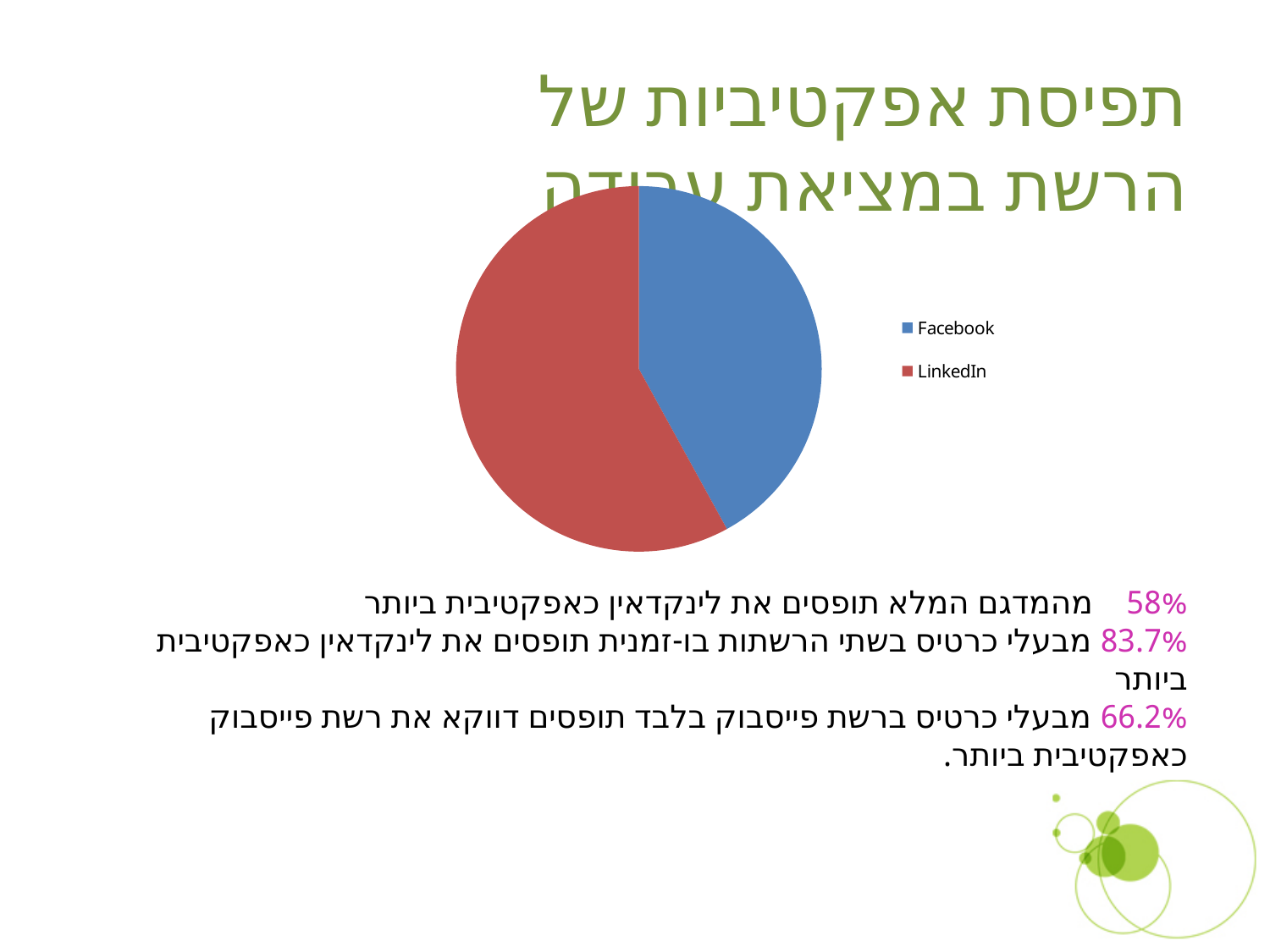
Which category has the largest slice in the pie chart? LinkedIn What colour is the Facebook slice in the pie chart? blue How many entries does the legend of the pie chart list? 2 How many slices does the pie chart have? 2 Which category has the smallest slice in the pie chart? Facebook Is the LinkedIn slice greater or less than half of the pie? greater Is the Facebook slice greater or less than half of the pie? less What colour is the LinkedIn slice in the pie chart? red What kind of chart is shown on the slide? pie chart Which slice of the pie chart is larger, Facebook or LinkedIn? LinkedIn